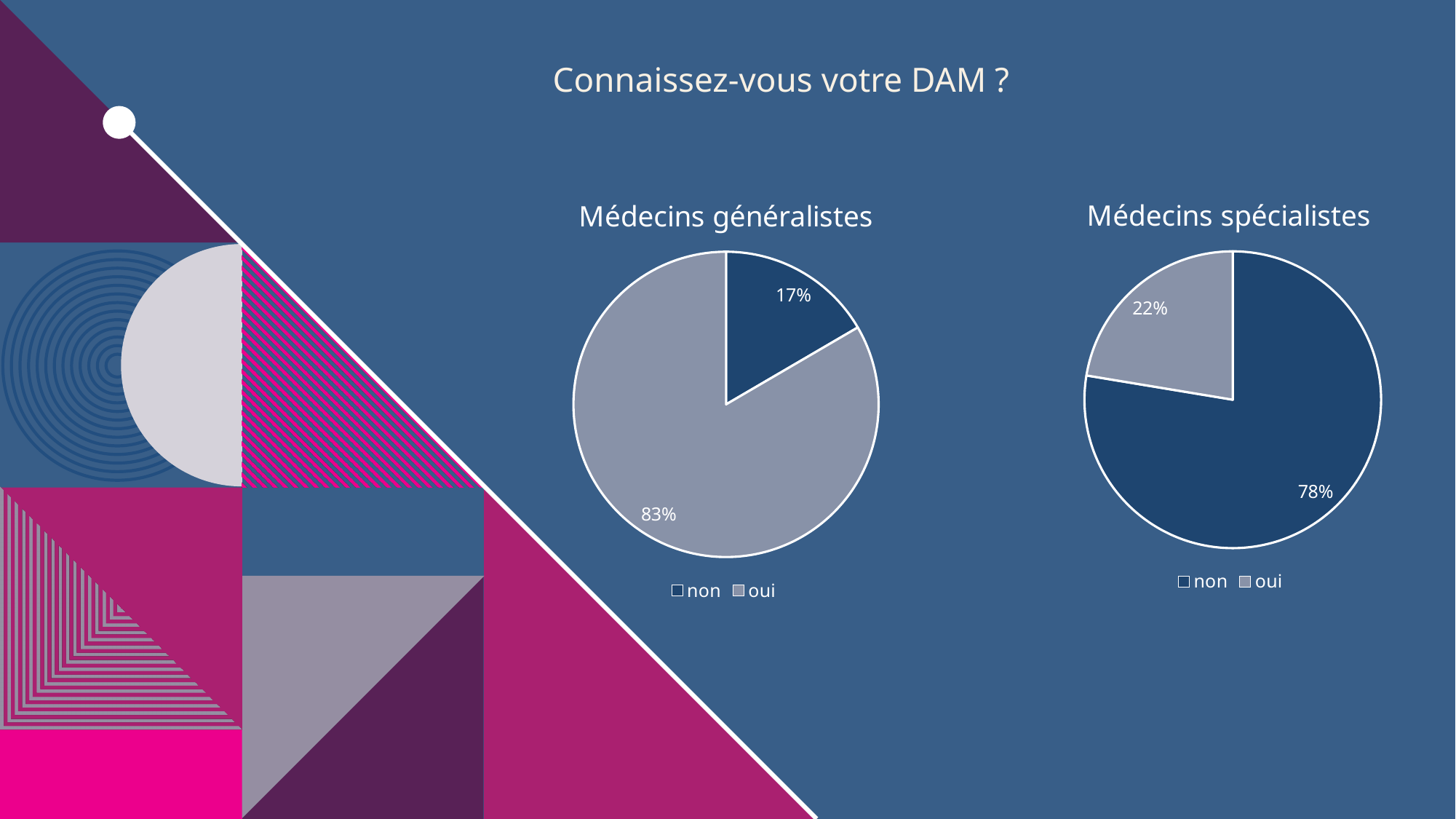
How many categories does the legend of the 'Médecins spécialistes' chart list? 2 In the 'Médecins spécialistes' chart, what percentage is shown for 'oui'? 22% Which is larger: the 'oui' share in the 'Médecins généralistes' chart or the 'oui' share in the 'Médecins spécialistes' chart? Médecins généralistes In the 'Médecins spécialistes' chart, what percentage is shown for 'non'? 78% What is the main title shown above the two charts on the slide? Connaissez-vous votre DAM ? In the 'Médecins généralistes' chart, what percentage is shown for 'non'? 17% In the 'Médecins spécialistes' chart, what is the difference in percentage points between 'non' and 'oui'? 56 What type of chart is used for 'Médecins généralistes'? Pie chart In the 'Médecins généralistes' chart, what percentage is shown for 'oui'? 83% In the 'Médecins généralistes' chart, which category has the largest slice? oui In the 'Médecins généralistes' chart, what is the difference in percentage points between 'oui' and 'non'? 66 In the 'Médecins spécialistes' chart, which category has the smallest slice? oui